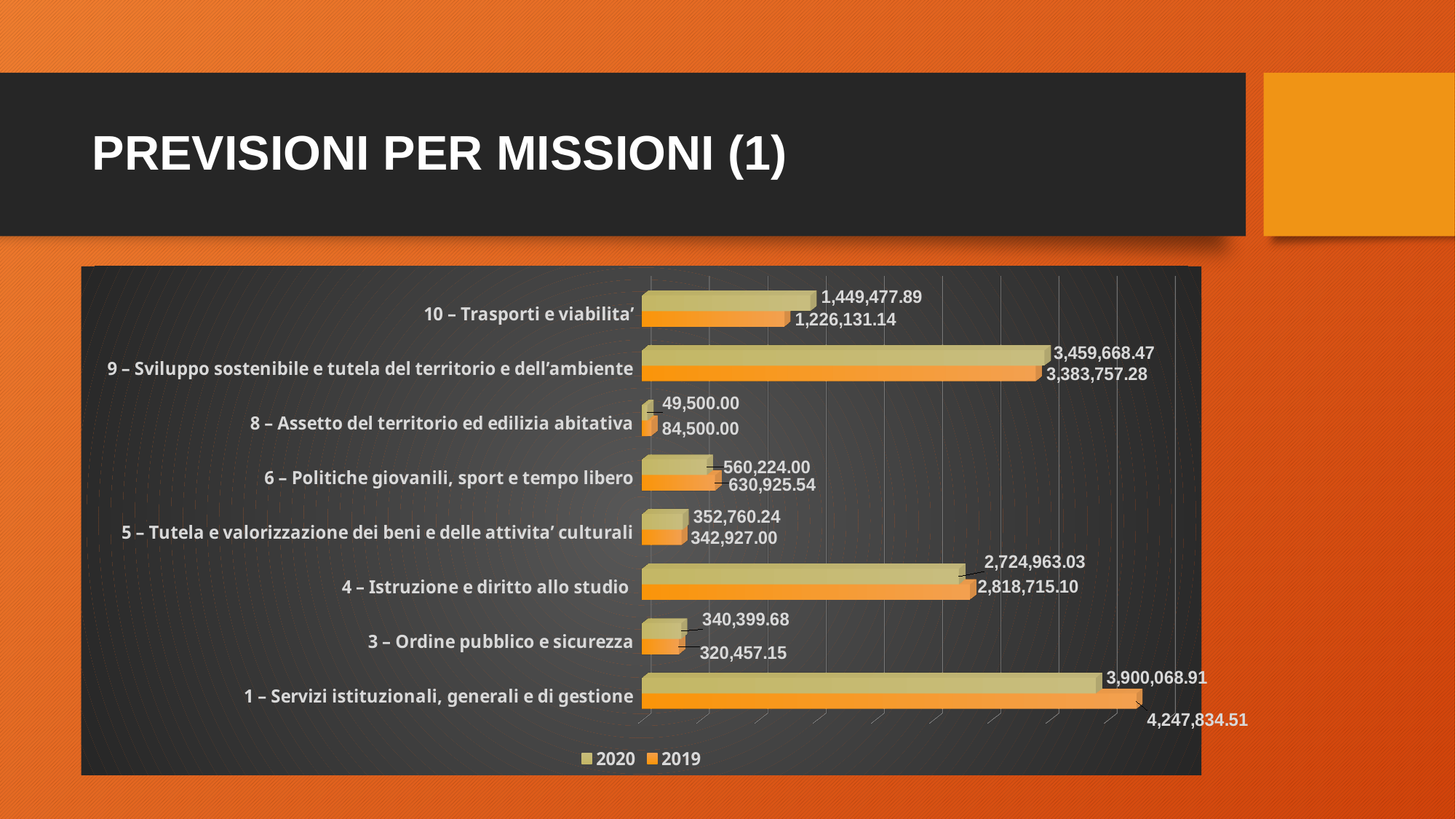
How many categories (missioni) are shown in the chart? 8 What is the 2019 value for "8 – Assetto del territorio ed edilizia abitativa"? 84,500.00 What is the difference between the 2019 and 2020 values for "1 – Servizi istituzionali, generali e di gestione"? 347,765.60 What is the difference between the 2020 and 2019 values for "8 – Assetto del territorio ed edilizia abitativa"? 35,000.00 For "9 – Sviluppo sostenibile e tutela del territorio e dell'ambiente", which year has the larger value, 2020 or 2019? 2020 What kind of chart is shown on the slide? Bar chart What is the 2020 value for "10 – Trasporti e viabilita'"? 1,449,477.89 How many series does the legend list? 2 For "6 – Politiche giovanili, sport e tempo libero", which year has the larger value, 2020 or 2019? 2019 Which category has the lowest 2019 value? 8 – Assetto del territorio ed edilizia abitativa Which category has the highest 2020 value? 1 – Servizi istituzionali, generali e di gestione What is the 2019 value for "4 – Istruzione e diritto allo studio"? 2,818,715.10